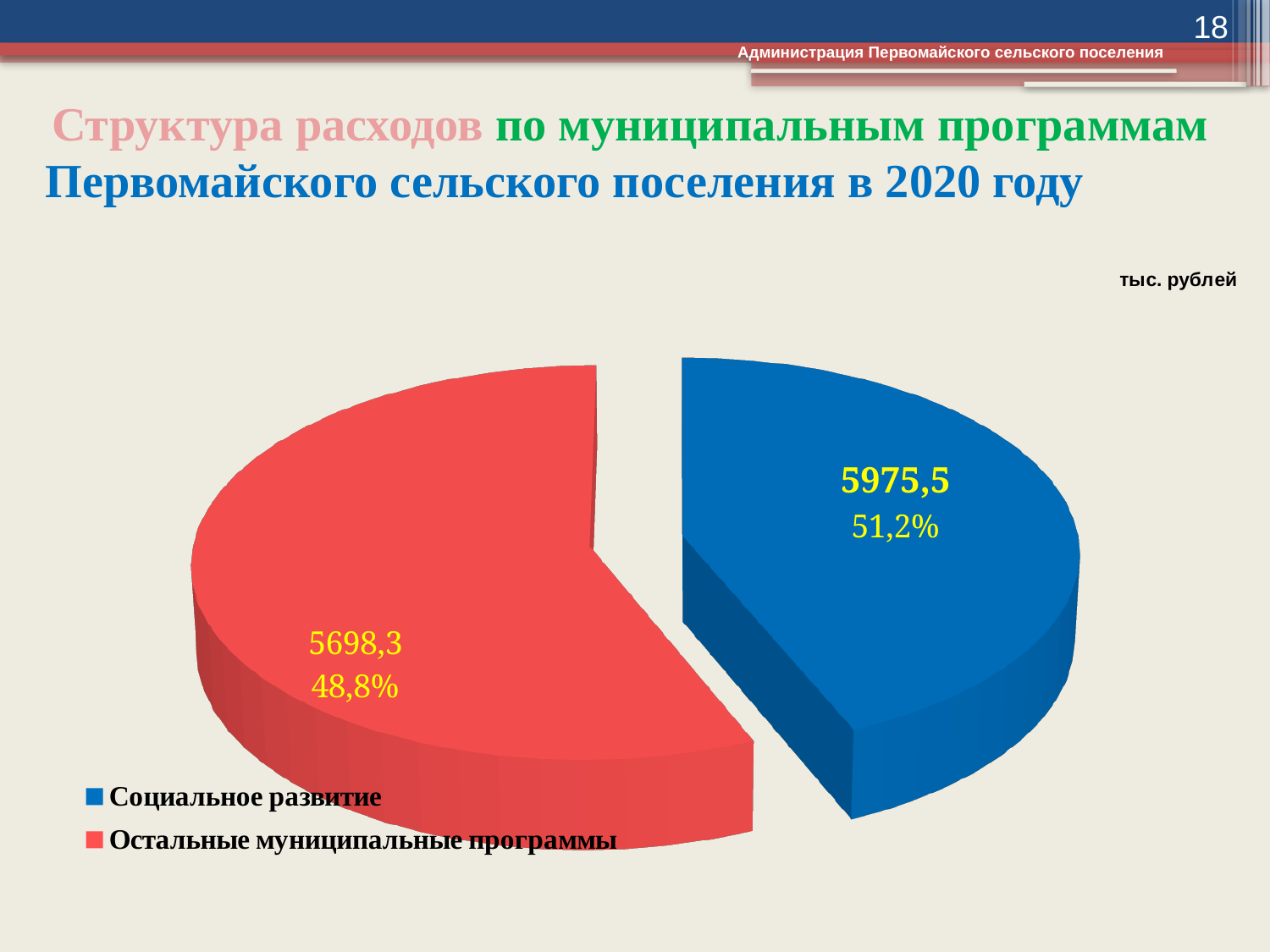
What colour is the slice for Остальные муниципальные программы? Red How many slices does the pie chart have? 2 What share of the pie does Остальные муниципальные программы take? 48,8% What kind of chart is shown on the slide? Pie chart What is the value for Остальные муниципальные программы? 5698,3 Which category has the largest slice of the pie? Социальное развитие Which is larger: Социальное развитие or Остальные муниципальные программы? Социальное развитие What share of the pie does Социальное развитие take? 51,2% Which category has the smallest slice of the pie? Остальные муниципальные программы What is the value for Социальное развитие? 5975,5 What is the difference between the values for Социальное развитие and Остальные муниципальные программы? 277,2 How many entries does the legend list? 2